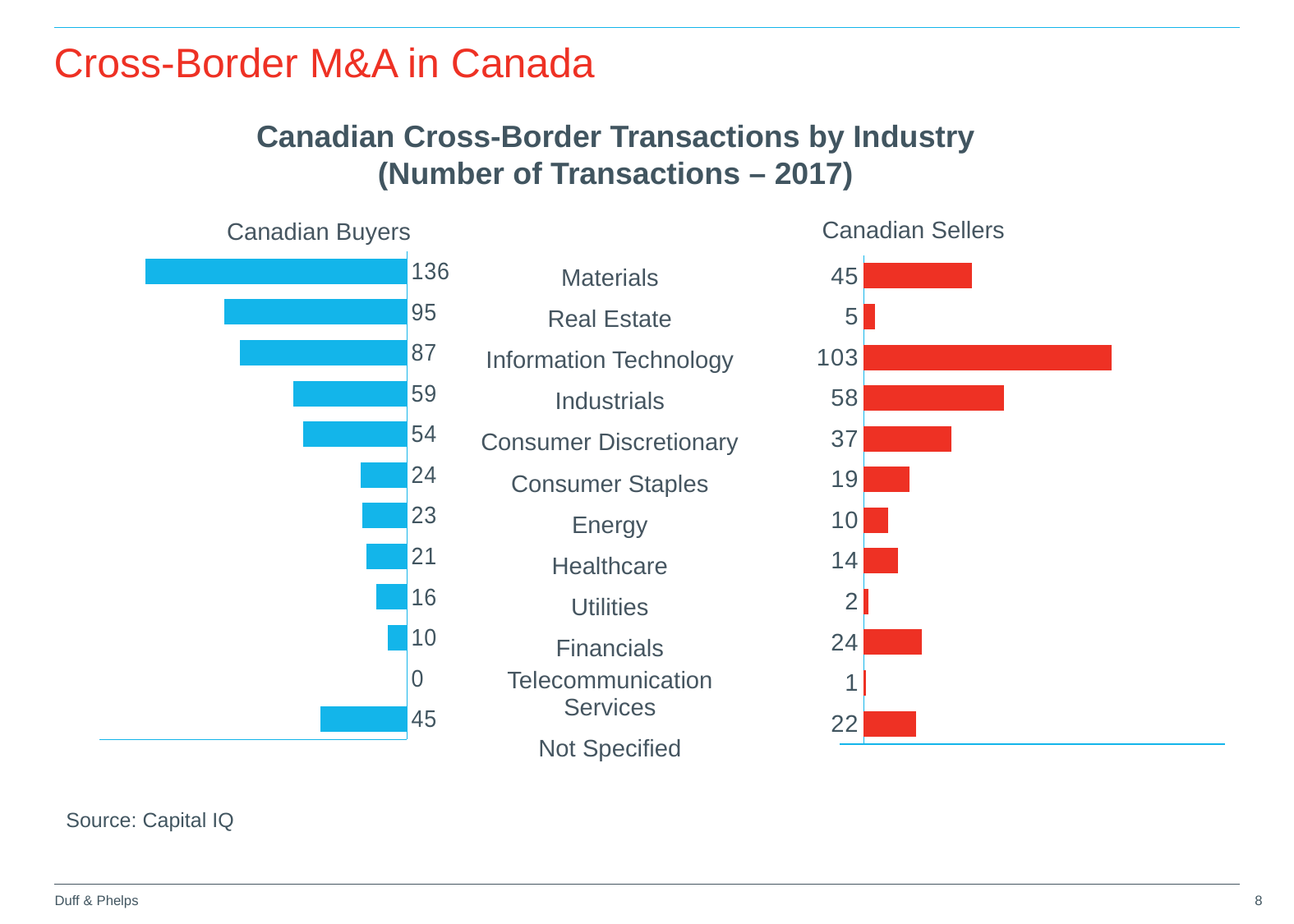
Which is larger for Industrials: the Canadian Buyers value or the Canadian Sellers value? Canadian Buyers In the Canadian Buyers chart, which industry has the highest number of transactions? Materials In the Canadian Buyers chart, which industry has the lowest number of transactions? Telecommunication Services In the Canadian Sellers chart, which is larger: Financials or Consumer Staples? Financials What type of chart is used for the Canadian Sellers data? Bar chart In the Canadian Buyers chart, how many transactions are shown for Materials? 136 In the Canadian Sellers chart, which industry has the lowest number of transactions? Telecommunication Services In the Canadian Sellers chart, how many transactions are shown for Information Technology? 103 In the Canadian Buyers chart, what is the difference between Materials and Real Estate? 41 How many industry categories are shown in the Canadian Buyers chart? 12 In the Canadian Sellers chart, what is the difference between Industrials and Consumer Discretionary? 21 What colour are the bars in the Canadian Buyers chart? Blue